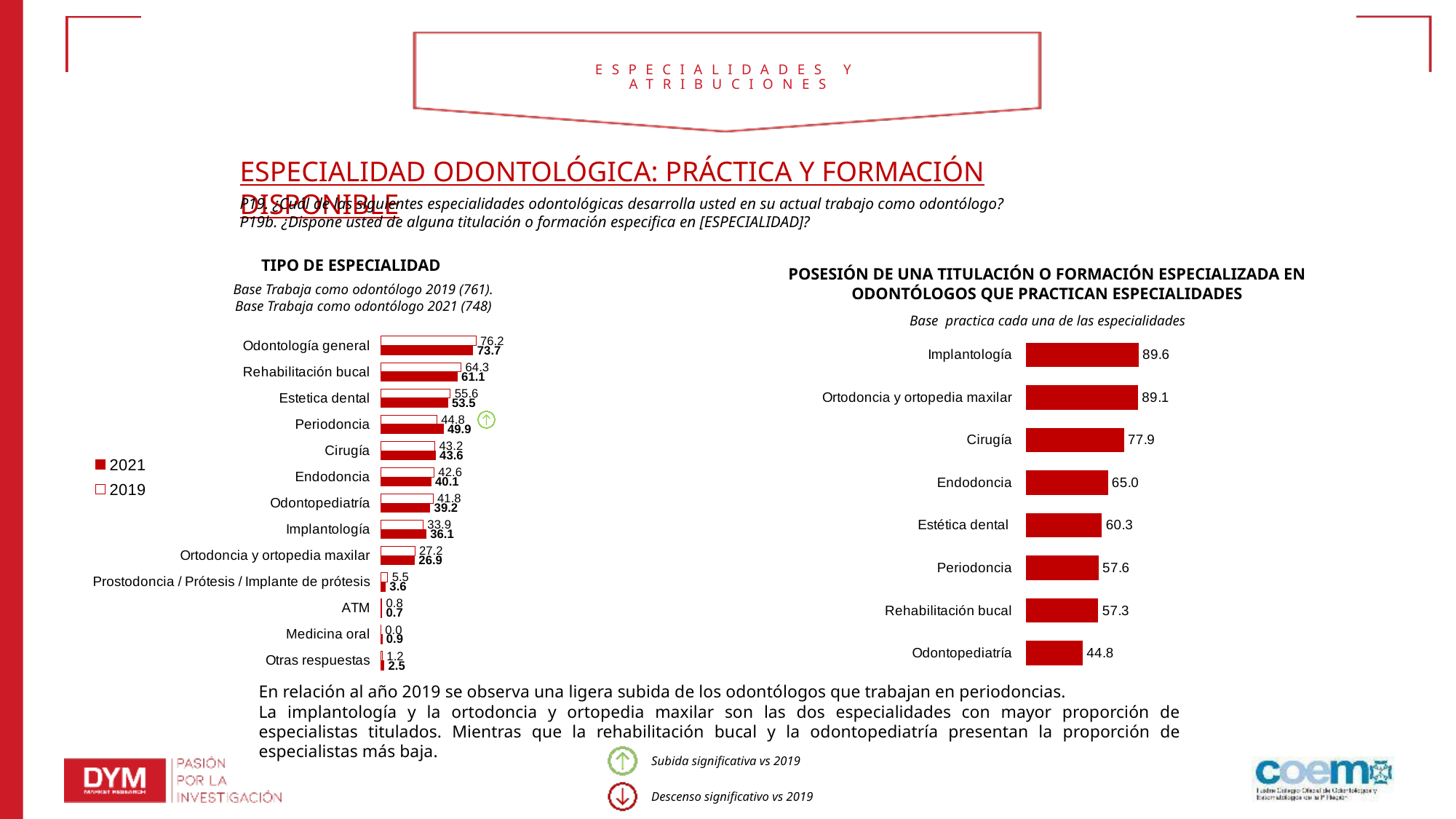
What kind of chart is the 'POSESIÓN DE UNA TITULACIÓN O FORMACIÓN ESPECIALIZADA' chart? Bar chart In the 'POSESIÓN DE UNA TITULACIÓN O FORMACIÓN ESPECIALIZADA' chart, which category has the lowest value? Odontopediatría In the 'TIPO DE ESPECIALIDAD' chart, what is the 2021 value for Periodoncia? 49.9 In the 'POSESIÓN DE UNA TITULACIÓN O FORMACIÓN ESPECIALIZADA' chart, what is the value for Cirugía? 77.9 How many categories are shown in the 'TIPO DE ESPECIALIDAD' chart? 13 How many series does the legend of the 'TIPO DE ESPECIALIDAD' chart list? 2 How many categories are shown in the 'POSESIÓN DE UNA TITULACIÓN O FORMACIÓN ESPECIALIZADA' chart? 8 In the 'TIPO DE ESPECIALIDAD' chart, what is the difference between the 2019 and 2021 values for Rehabilitación bucal? 3.2 In the 'TIPO DE ESPECIALIDAD' chart, which category has the highest 2021 value? Odontología general In the 'TIPO DE ESPECIALIDAD' chart, which is larger for Implantología: the 2019 value or the 2021 value? 2021 In the 'TIPO DE ESPECIALIDAD' chart, what is the 2019 value for Odontología general? 76.2 In the 'POSESIÓN DE UNA TITULACIÓN O FORMACIÓN ESPECIALIZADA' chart, what is the difference between Implantología and Endodoncia? 24.6